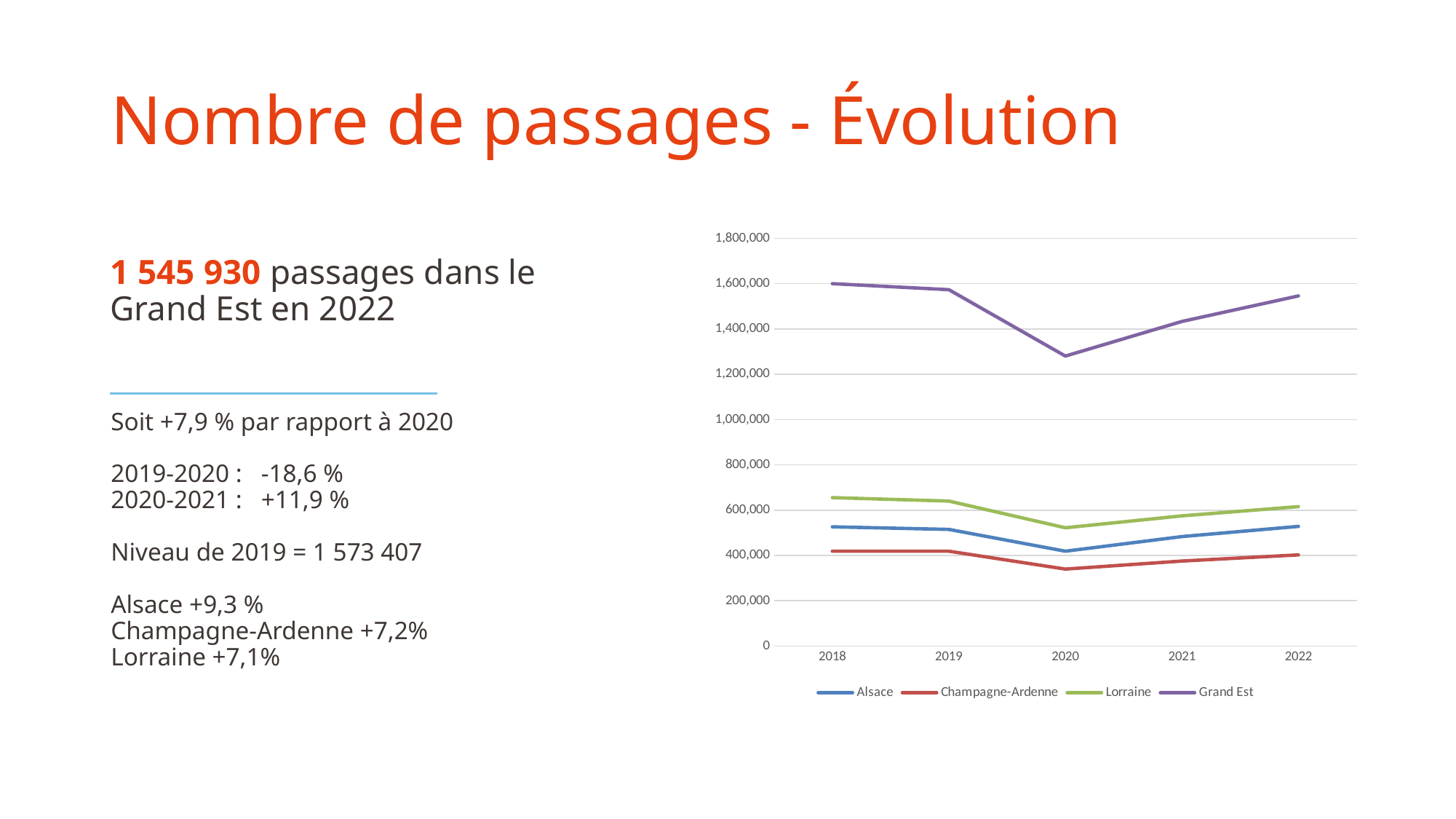
Is the value for Grand Est in 2020 greater or less than 1,200,000? greater Is the value for Lorraine in 2018 greater or less than 600,000? greater Which is larger in 2019, the value for Lorraine or the value for Alsace? Lorraine How many years are plotted along the x axis of the chart? 5 What kind of chart is shown on the slide? line chart How many series does the chart legend list? 4 Is the value for Champagne-Ardenne in 2020 greater or less than 400,000? less Which series has the lowest value in 2020? Champagne-Ardenne Does the Grand Est line rise or fall between 2020 and 2022? rise Which series has the highest values across all years in the chart? Grand Est What colour is the Grand Est line in the chart? purple In which year does the Grand Est line reach its lowest point? 2020